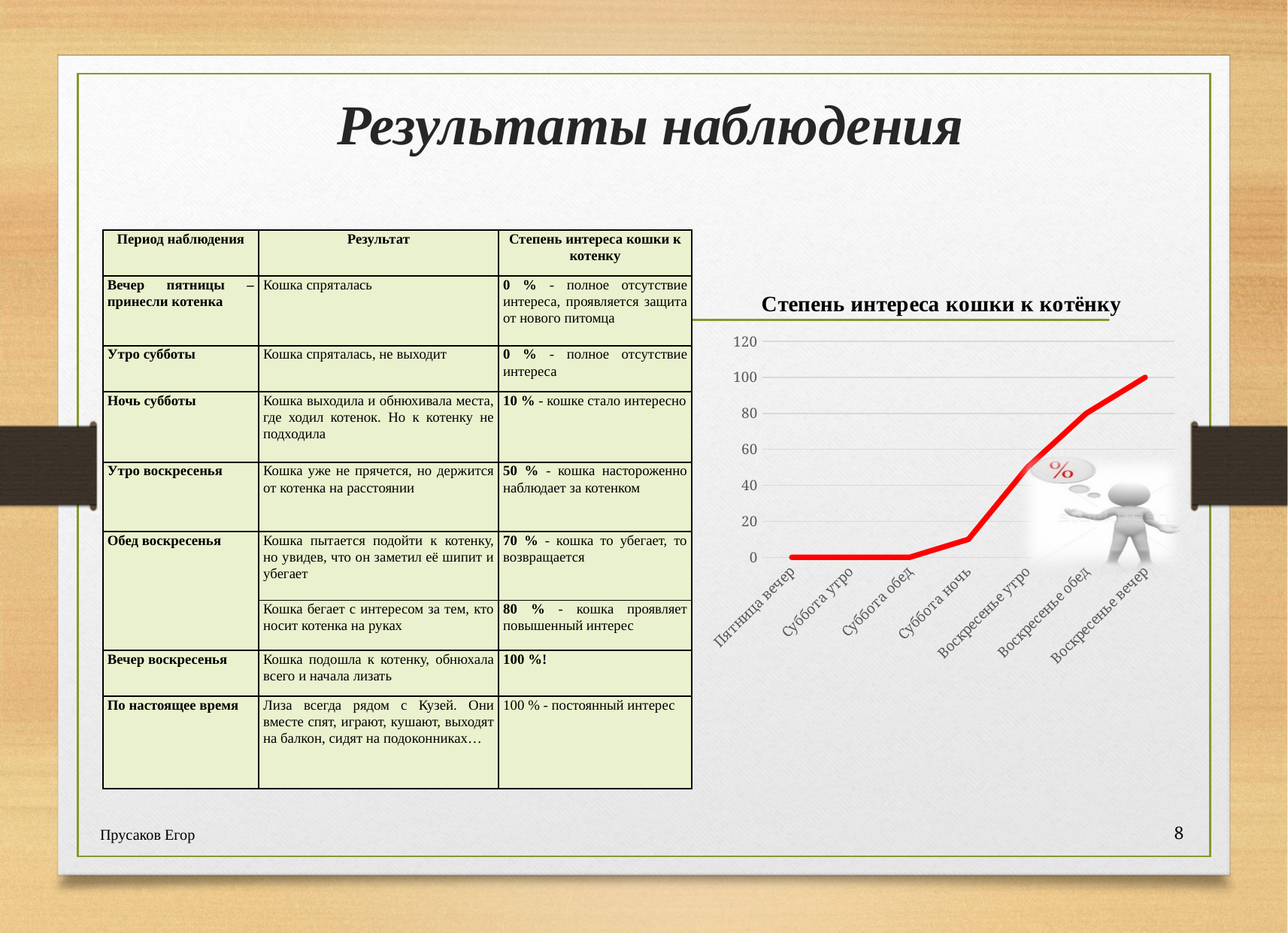
What is the difference between the values for Воскресенье вечер and Воскресенье обед in the chart? 20 What is the value for Воскресенье вечер in the chart? 100 What is the value for Воскресенье обед in the chart? 80 What is the title of the chart? Степень интереса кошки к котёнку What kind of chart is shown on the slide? line chart Which category has the highest value in the chart? Воскресенье вечер What is the value for Пятница вечер in the chart? 0 How many categories are plotted along the x axis of the chart? 7 Which is larger in the chart: the value for Воскресенье обед or the value for Суббота ночь? Воскресенье обед Is the value for Воскресенье утро greater or less than 40? greater Do the values in the chart rise or fall from Пятница вечер to Воскресенье вечер? rise Is the value for Суббота ночь greater or less than 20? less